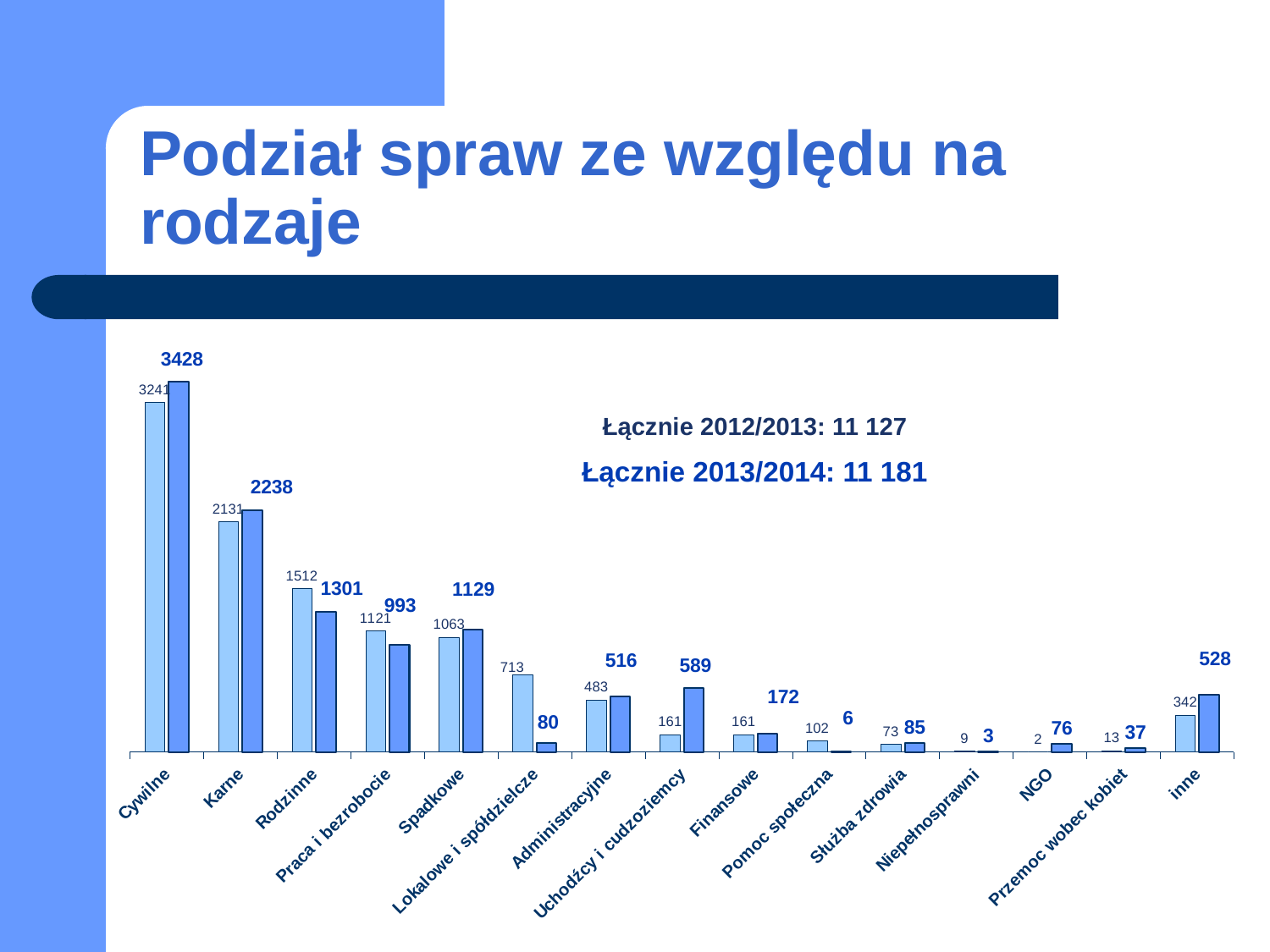
Which is larger for Rodzinne: the lighter bar (1512) or the darker bar (1301)? the lighter bar (1512) What is the title of the slide containing the chart? Podział spraw ze względu na rodzaje What is the value of the darker (second) bar for Cywilne? 3428 What is the value of the lighter (first) bar for Cywilne? 3241 What is the value of the lighter (first) bar for Lokalowe i spółdzielcze? 713 What type of chart is shown on the slide? bar chart Which category has the highest values in the chart? Cywilne What is the value of the darker (second) bar for Uchodźcy i cudzoziemcy? 589 How many categories are shown on the x axis of the chart? 15 What total is given on the slide for 2013/2014? 11 181 What is the value of the darker (second) bar for NGO? 76 What is the difference between the two bars for Karne (2238 and 2131)? 107